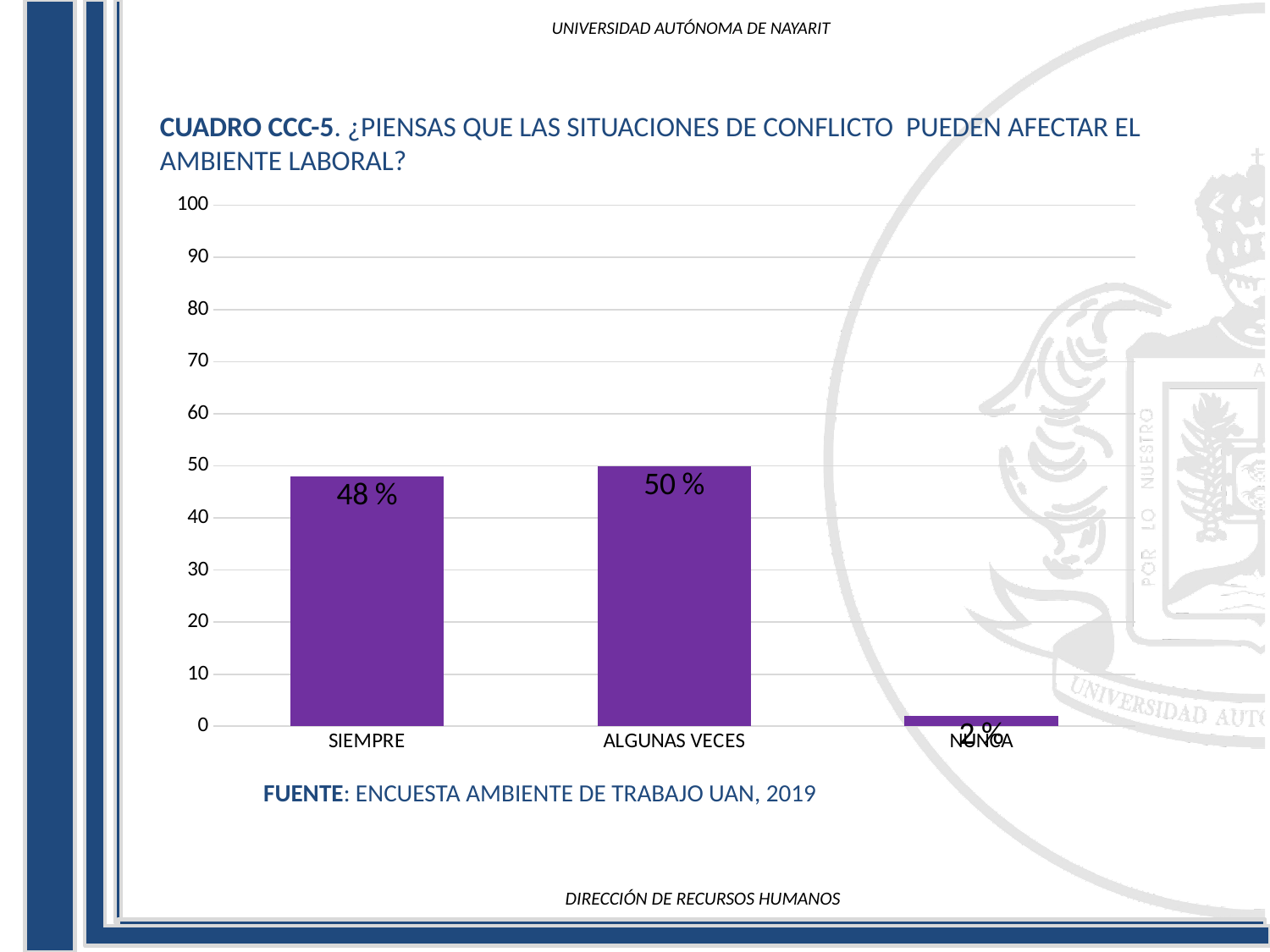
Which category has the highest value? ALGUNAS VECES What kind of chart is shown on the slide? bar chart How many categories are shown on the x axis? 3 Which category has the lowest value? NUNCA What is the difference between the values for SIEMPRE and NUNCA? 46 % What is the difference between the values for ALGUNAS VECES and SIEMPRE? 2 % What is the value for NUNCA? 2 % What is the value for ALGUNAS VECES? 50 % What is the value for SIEMPRE? 48 % Is the value for SIEMPRE greater or less than 40? greater Which is larger, the value for SIEMPRE or the value for NUNCA? SIEMPRE What source is cited below the chart? ENCUESTA AMBIENTE DE TRABAJO UAN, 2019